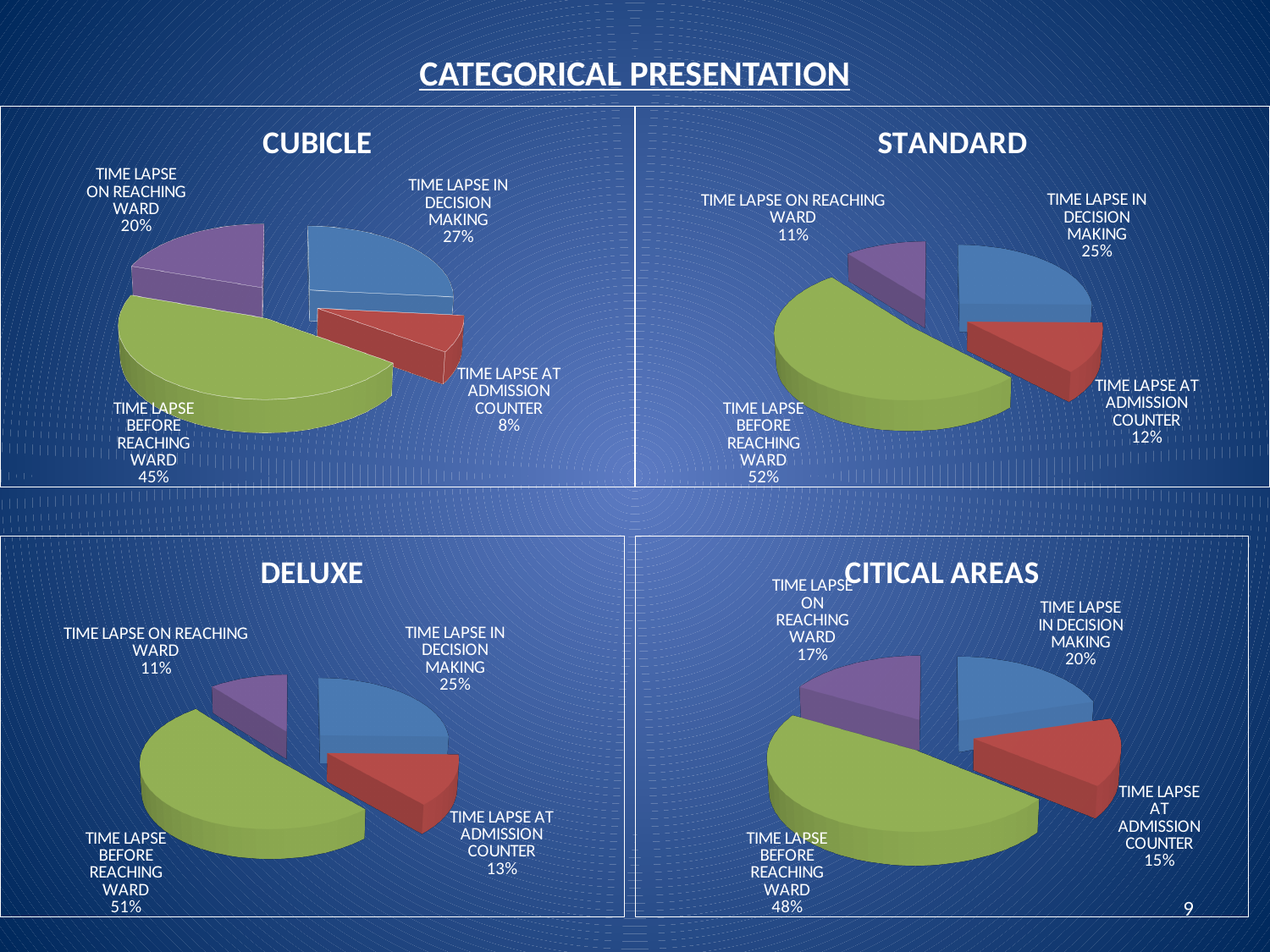
In the CUBICLE chart, which category has the smallest slice? TIME LAPSE AT ADMISSION COUNTER In the CUBICLE chart, what is the difference between TIME LAPSE IN DECISION MAKING and TIME LAPSE ON REACHING WARD? 7% In the STANDARD chart, which category has the largest slice? TIME LAPSE BEFORE REACHING WARD How many categories does the STANDARD pie chart contain? 4 What kind of chart is used in the DELUXE panel? Pie chart In the DELUXE chart, what is the difference between TIME LAPSE BEFORE REACHING WARD and TIME LAPSE IN DECISION MAKING? 26% In the CITICAL AREAS chart, which is larger: TIME LAPSE IN DECISION MAKING or TIME LAPSE AT ADMISSION COUNTER? TIME LAPSE IN DECISION MAKING In the STANDARD chart, what percentage is labelled for TIME LAPSE IN DECISION MAKING? 25% In the CITICAL AREAS chart, what percentage is shown for TIME LAPSE ON REACHING WARD? 17% How many pie charts are shown on the slide? 4 In the DELUXE chart, what percentage is shown for TIME LAPSE AT ADMISSION COUNTER? 13% In the CUBICLE chart, what share is shown for TIME LAPSE BEFORE REACHING WARD? 45%